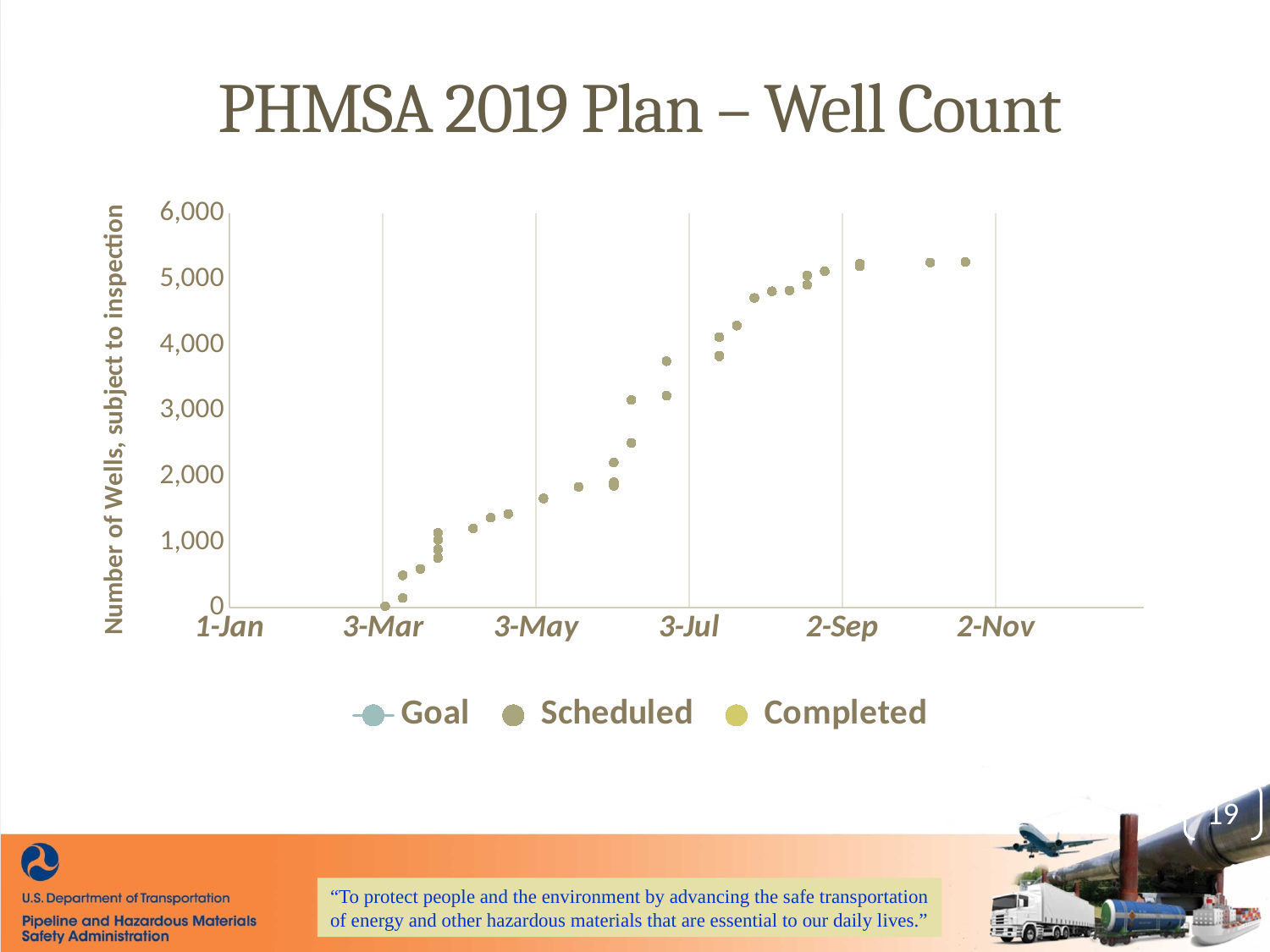
Are the plotted points near 2-Sep greater or less than 4,000? greater What kind of chart is shown on the slide? Scatter chart Is the value of the first plotted point, near 3-Mar, greater or less than 1,000? less What is the title of the slide containing the chart? PHMSA 2019 Plan – Well Count Is the value of the last plotted point, near 2-Nov, greater or less than 5,000? greater How many series does the legend list? 3 Do the plotted values rise or fall as the dates move from 3-Mar toward 2-Nov? Rise How many date labels are shown on the x axis? 6 What is the highest value shown on the y axis? 6,000